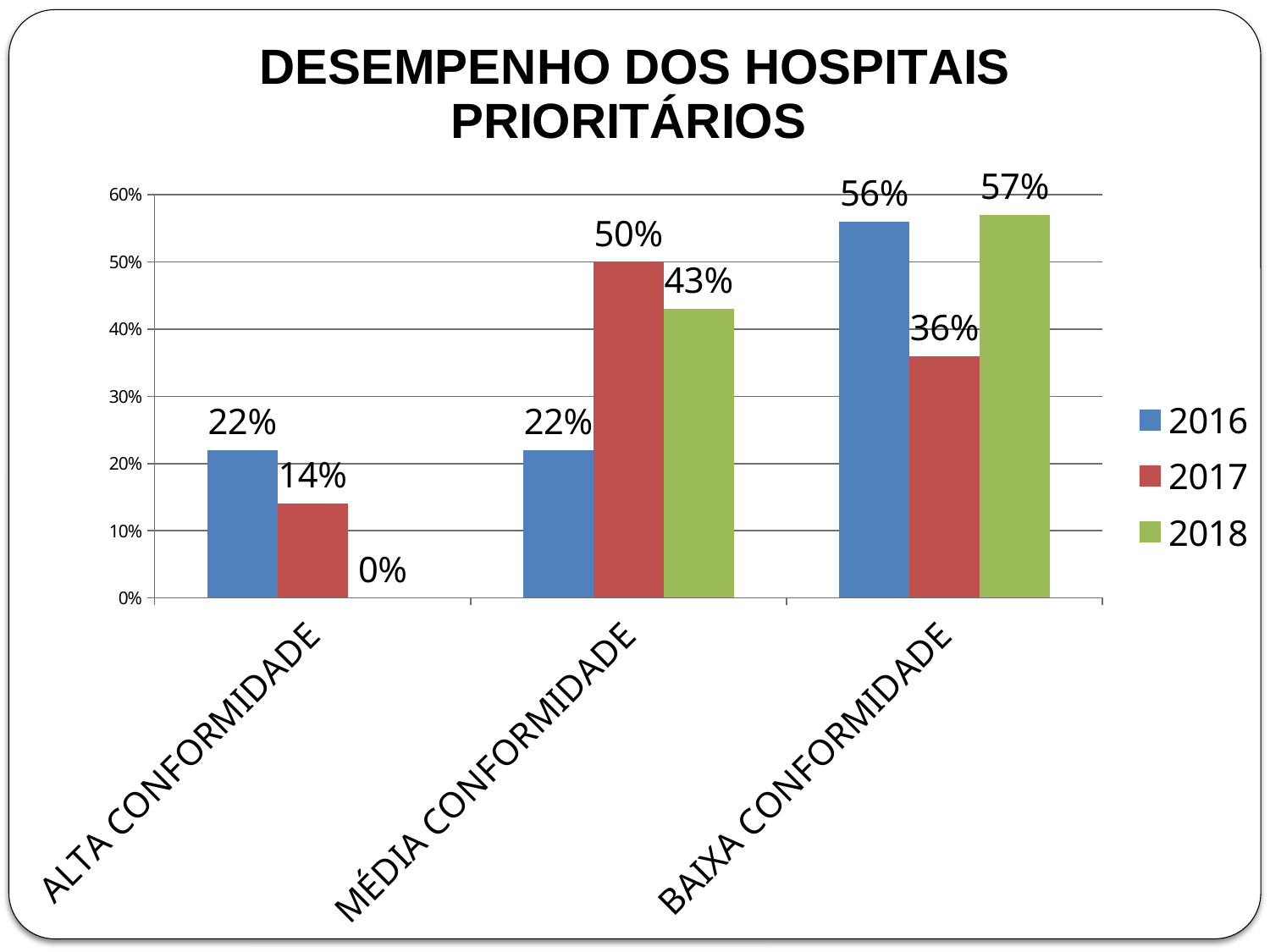
What is the value for 2018 in the ALTA CONFORMIDADE category? 0% What is the difference between the 2016 and 2017 values in the BAIXA CONFORMIDADE category? 20% What kind of chart is shown on the slide? Bar chart Which category has the lowest value for the 2017 series? ALTA CONFORMIDADE Which is larger in the MÉDIA CONFORMIDADE category: the 2017 value or the 2018 value? 2017 How many series does the legend list? 3 What is the value for 2017 in the MÉDIA CONFORMIDADE category? 50% What is the value for 2016 in the BAIXA CONFORMIDADE category? 56% What is the title of the chart? DESEMPENHO DOS HOSPITAIS PRIORITÁRIOS Does the 2016 series rise or fall from MÉDIA CONFORMIDADE to BAIXA CONFORMIDADE? Rise Which category has the highest value for the 2018 series? BAIXA CONFORMIDADE How many categories are shown on the x axis? 3